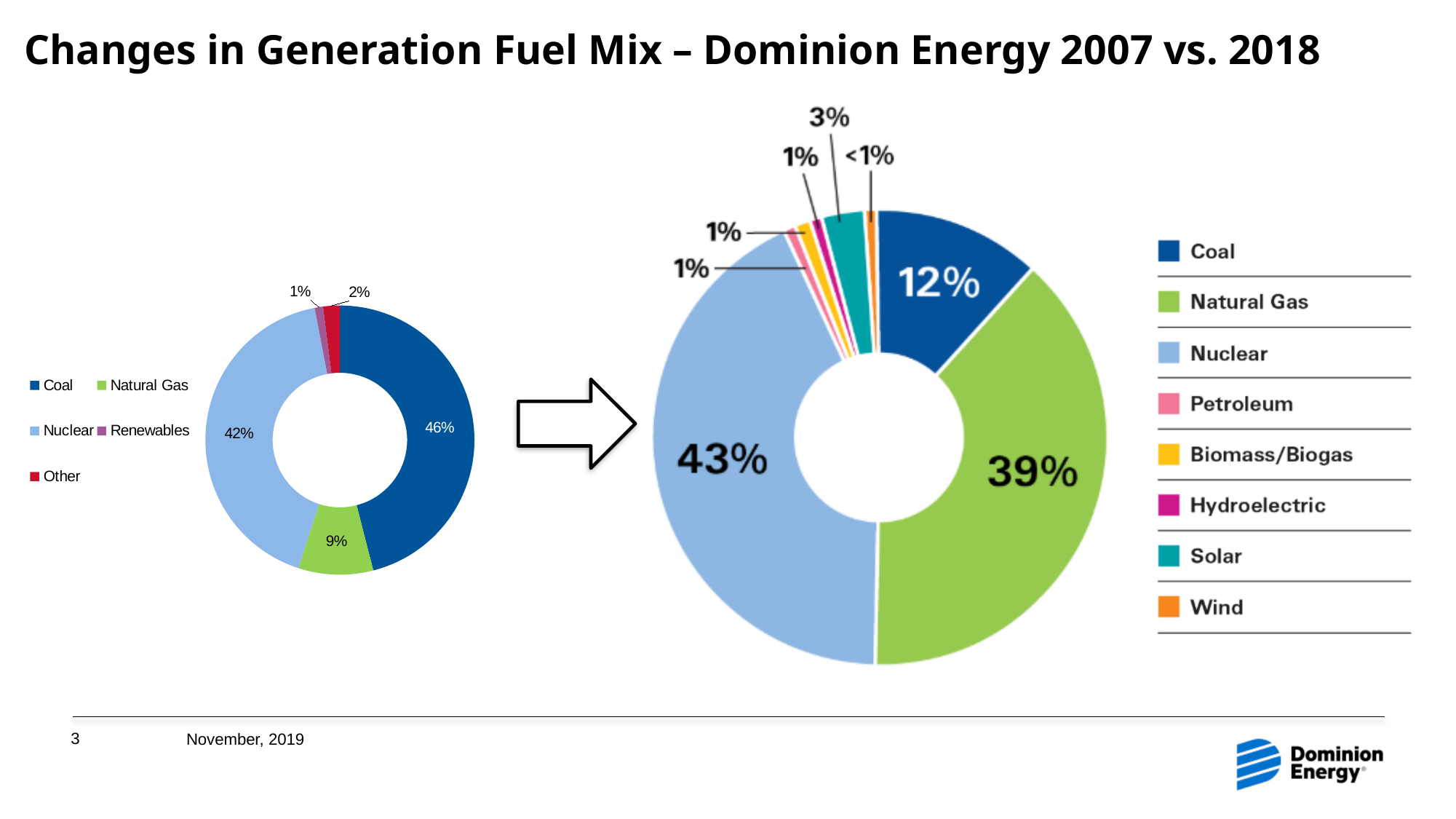
On the left chart (2007), which fuel has the smallest share? Renewables On the left chart (2007), which fuel has the largest share? Coal On the right chart (2018), how many fuel categories does the legend list? 8 On the right chart (2018), what share of generation is Nuclear? 43% What is the difference between the Coal share on the left chart (2007) and the Coal share on the right chart (2018)? 34 percentage points On the right chart (2018), what share of generation is Solar? 3% On the left chart (2007), how many fuel categories does the legend list? 5 On the left chart (2007), what share of generation is Coal? 46% On the right chart (2018), which fuel has the largest share? Nuclear On the left chart (2007), what share of generation is Natural Gas? 9% What type of chart is used on this slide? Donut (pie) chart On the right chart (2018), what share of generation is Natural Gas? 39%